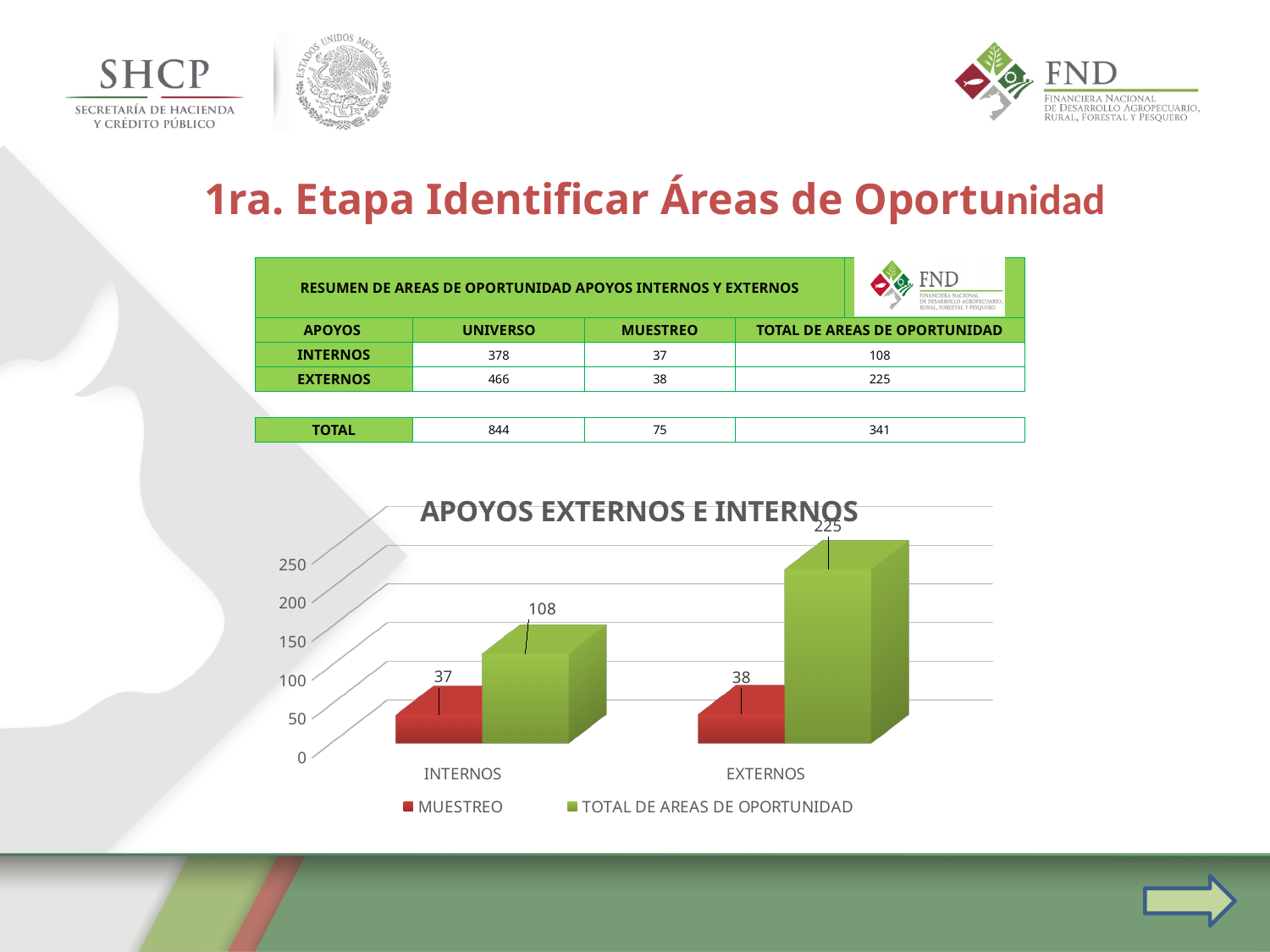
Which category has the highest TOTAL DE AREAS DE OPORTUNIDAD value in the chart? EXTERNOS Which is larger in the chart: the TOTAL DE AREAS DE OPORTUNIDAD for INTERNOS or the MUESTREO for EXTERNOS? TOTAL DE AREAS DE OPORTUNIDAD for INTERNOS How many series does the chart legend list? 2 What is the MUESTREO value for EXTERNOS in the chart? 38 What is the TOTAL DE AREAS DE OPORTUNIDAD value for EXTERNOS in the chart? 225 How many categories are shown on the x axis of the chart? 2 What is the MUESTREO value for INTERNOS in the chart? 37 What is the TOTAL DE AREAS DE OPORTUNIDAD value for INTERNOS in the chart? 108 What is the title of the chart? APOYOS EXTERNOS E INTERNOS What kind of chart is shown on the slide? bar chart What is the difference between the TOTAL DE AREAS DE OPORTUNIDAD values for EXTERNOS and INTERNOS? 117 Is the TOTAL DE AREAS DE OPORTUNIDAD value for EXTERNOS greater or less than 200? greater